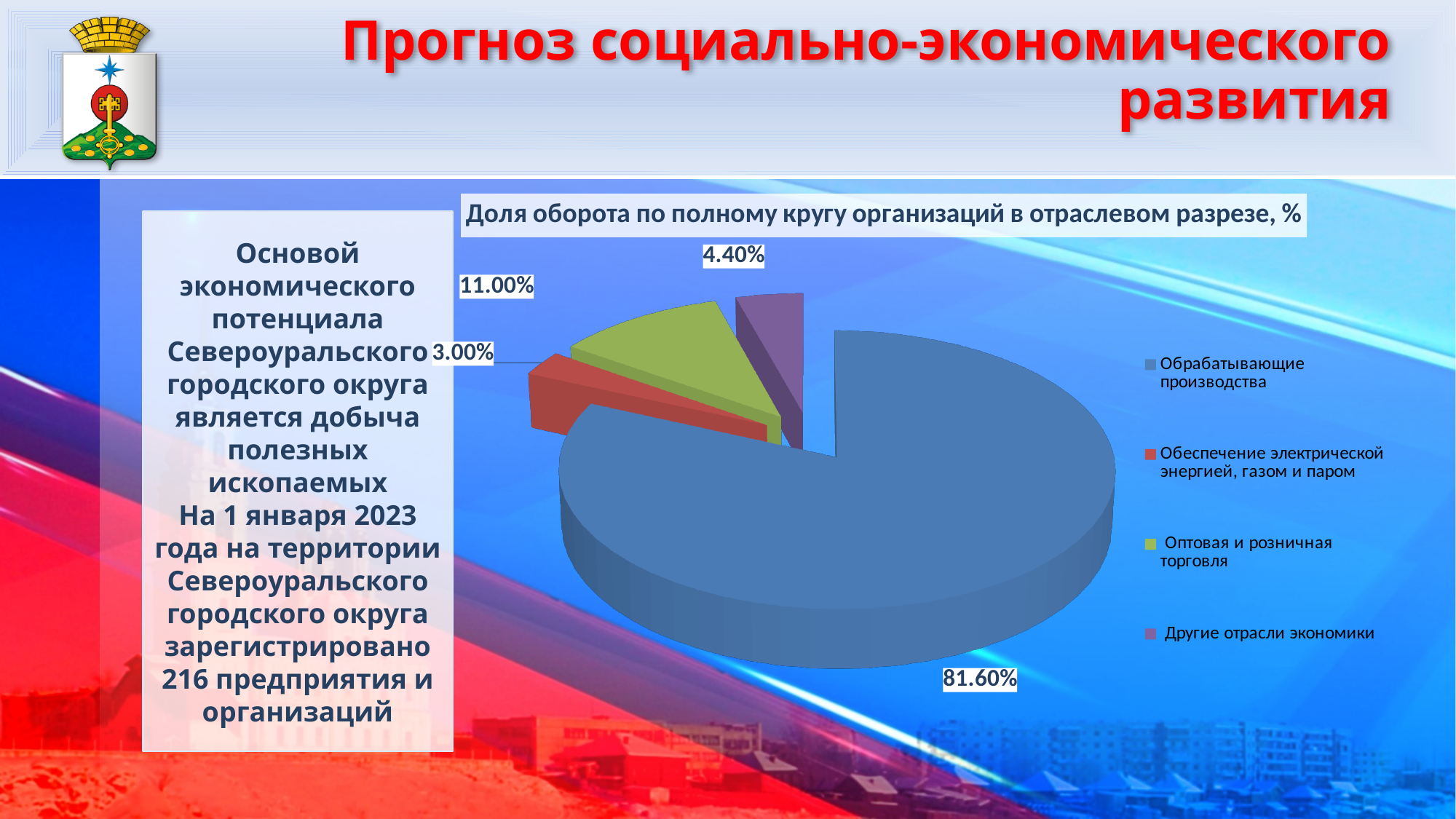
What share of turnover is attributed to Обрабатывающие производства? 81.60% Which is larger: the share of Другие отрасли экономики or the share of Обеспечение электрической энергией, газом и паром? Другие отрасли экономики How many sectors are shown in the pie chart? 4 What type of chart is shown on the slide? Pie chart What is the difference between the shares of Оптовая и розничная торговля and Другие отрасли экономики? 6.60% What share of turnover is attributed to Другие отрасли экономики? 4.40% What colour is the slice for Оптовая и розничная торговля? Green Which sector has the largest share of turnover? Обрабатывающие производства What share of turnover is attributed to Обеспечение электрической энергией, газом и паром? 3.00% What share of turnover is attributed to Оптовая и розничная торговля? 11.00% What is the title of the chart? Доля оборота по полному кругу организаций в отраслевом разрезе, % Which sector has the smallest share of turnover? Обеспечение электрической энергией, газом и паром